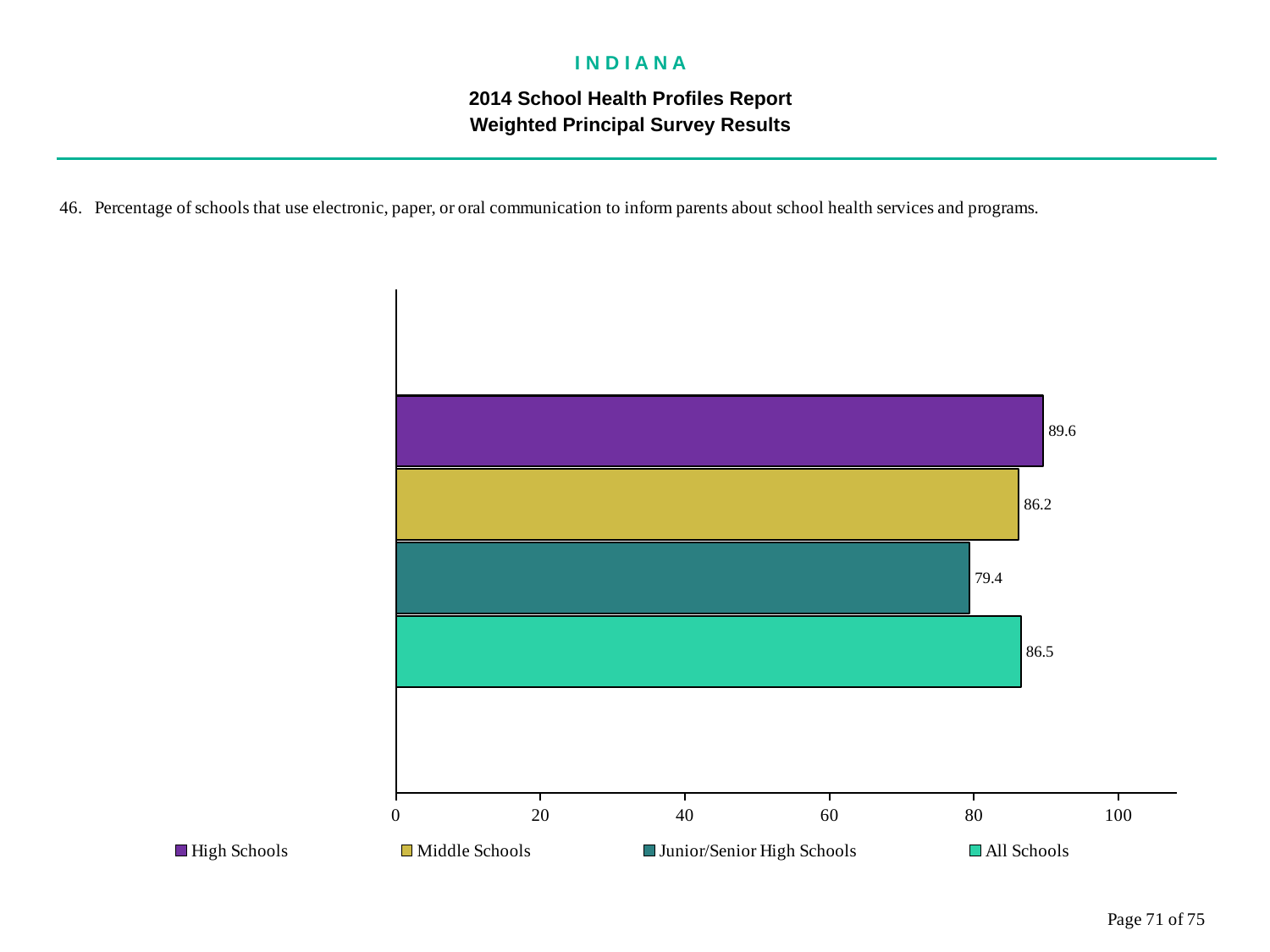
What kind of chart is shown on the slide? bar chart Is the value for Junior/Senior High Schools greater or less than 80? less What is the value for Junior/Senior High Schools? 79.4 What is the value for Middle Schools? 86.2 How many series does the legend list? 4 What is the value for High Schools? 89.6 What is the difference between the values for All Schools and Middle Schools? 0.3 Which school type has the highest value? High Schools Which school type has the lowest value? Junior/Senior High Schools What is the value for All Schools? 86.5 Which is larger, the value for High Schools or the value for Middle Schools? High Schools What is the difference between the values for High Schools and Junior/Senior High Schools? 10.2